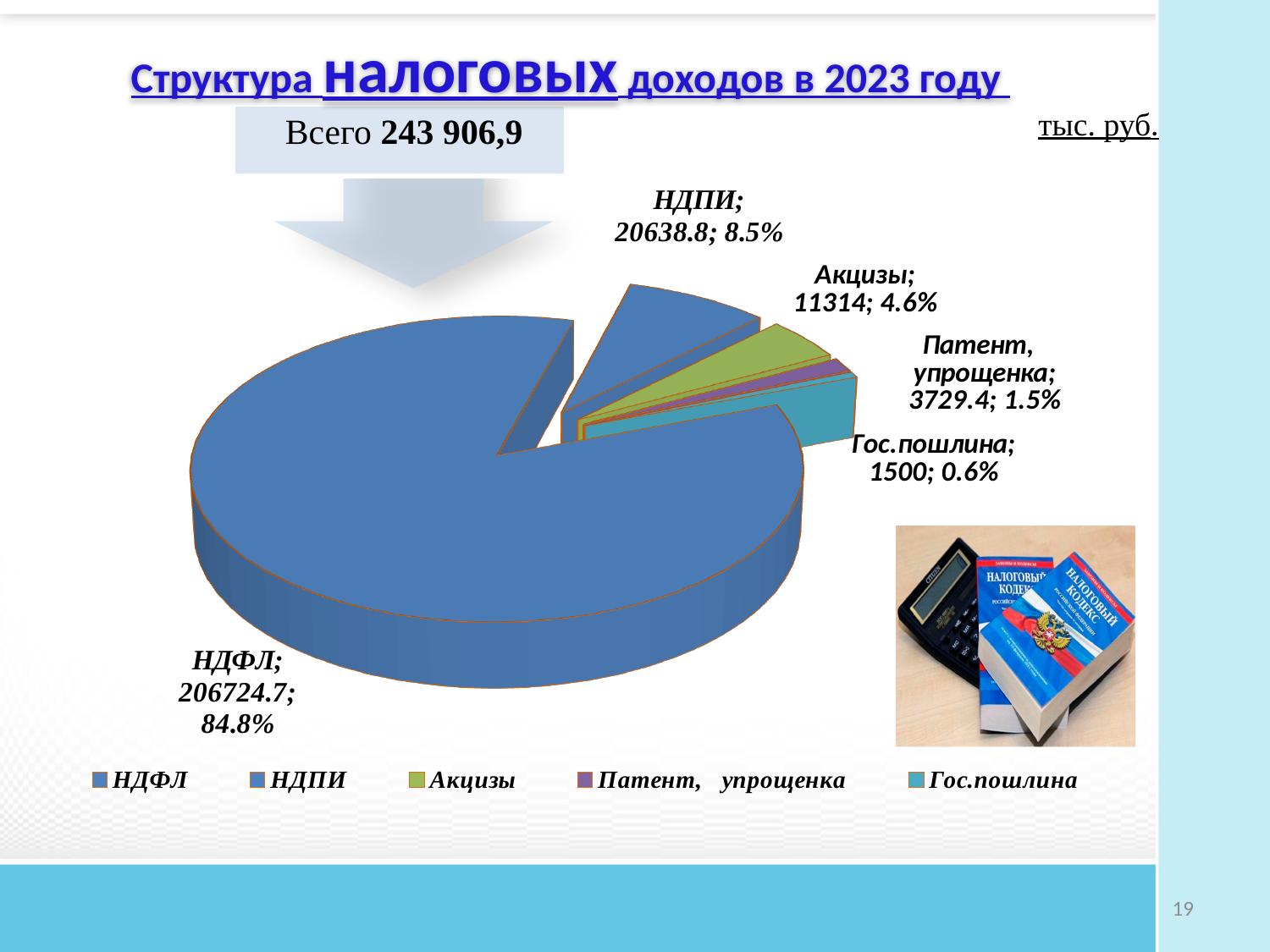
Which is larger, НДПИ or Акцизы? НДПИ What is the value for Акцизы? 11314 What is the difference between the values for НДПИ and Акцизы? 9324.8 What total is shown above the chart (Всего)? 243 906,9 What share of the pie does Патент, упрощенка represent? 1.5% Which category has the smallest slice? Гос.пошлина What is the value for Гос.пошлина? 1500 What kind of chart is shown on the slide? pie chart Which category has the largest slice? НДФЛ What is the value for НДФЛ? 206724.7 What share of the pie does НДПИ represent? 8.5% How many categories does the pie chart have? 5